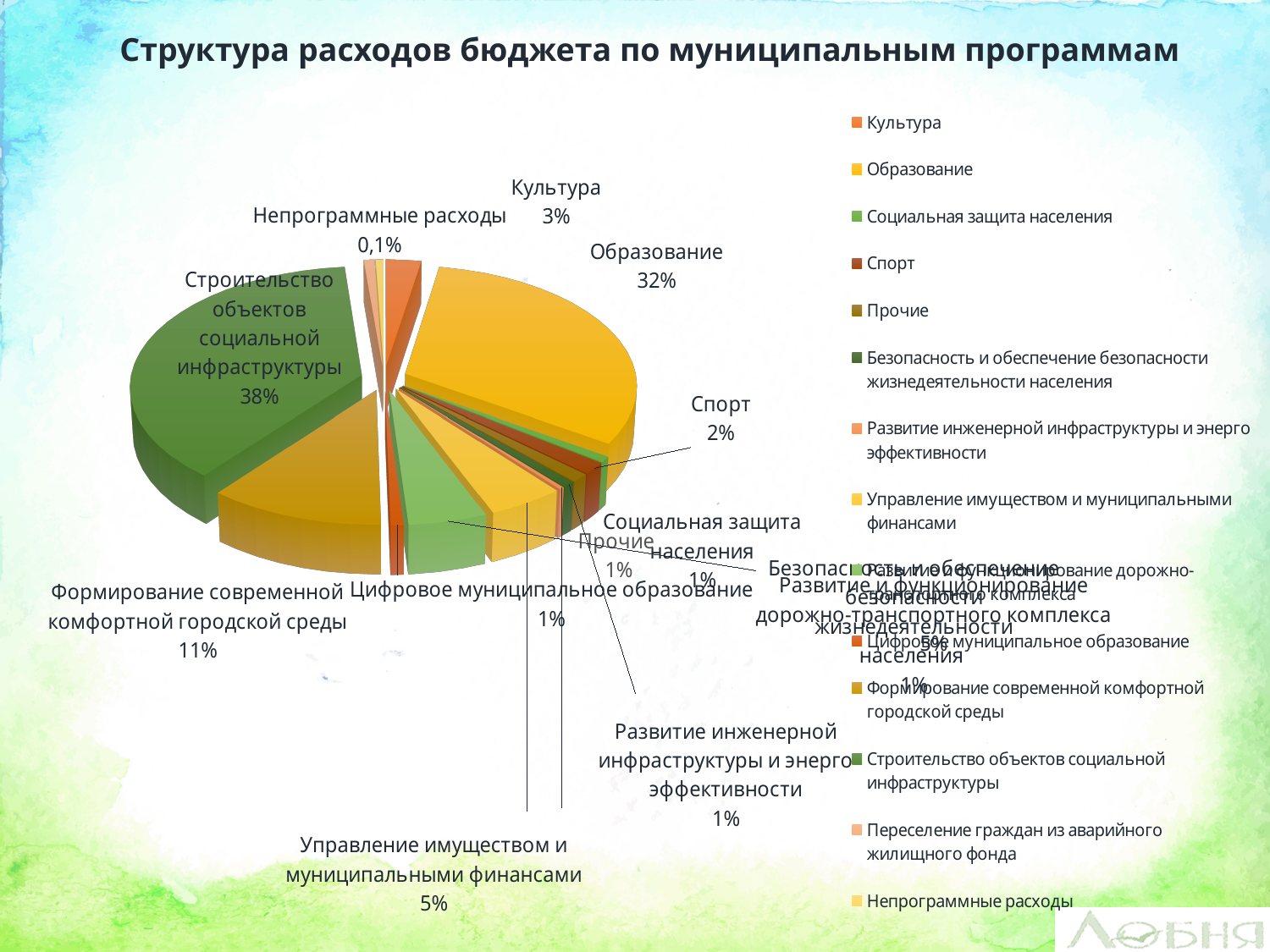
What value is shown for Непрограммные расходы? 0,1% How many entries does the legend list? 14 What type of chart is shown on the slide? Pie chart What share of the pie does Образование account for? 32% By how many percentage points does Строительство объектов социальной инфраструктуры exceed Образование? 6 Which is larger: the share for Культура or the share for Спорт? Культура What percentage is labelled for Управление имуществом и муниципальными финансами? 5% What percentage is shown for Строительство объектов социальной инфраструктуры? 38% Which labelled category has the smallest share of the pie? Непрограммные расходы What share is shown for Формирование современной комфортной городской среды? 11% What is the value labelled for Культура? 3% Which category has the largest share of the pie? Строительство объектов социальной инфраструктуры